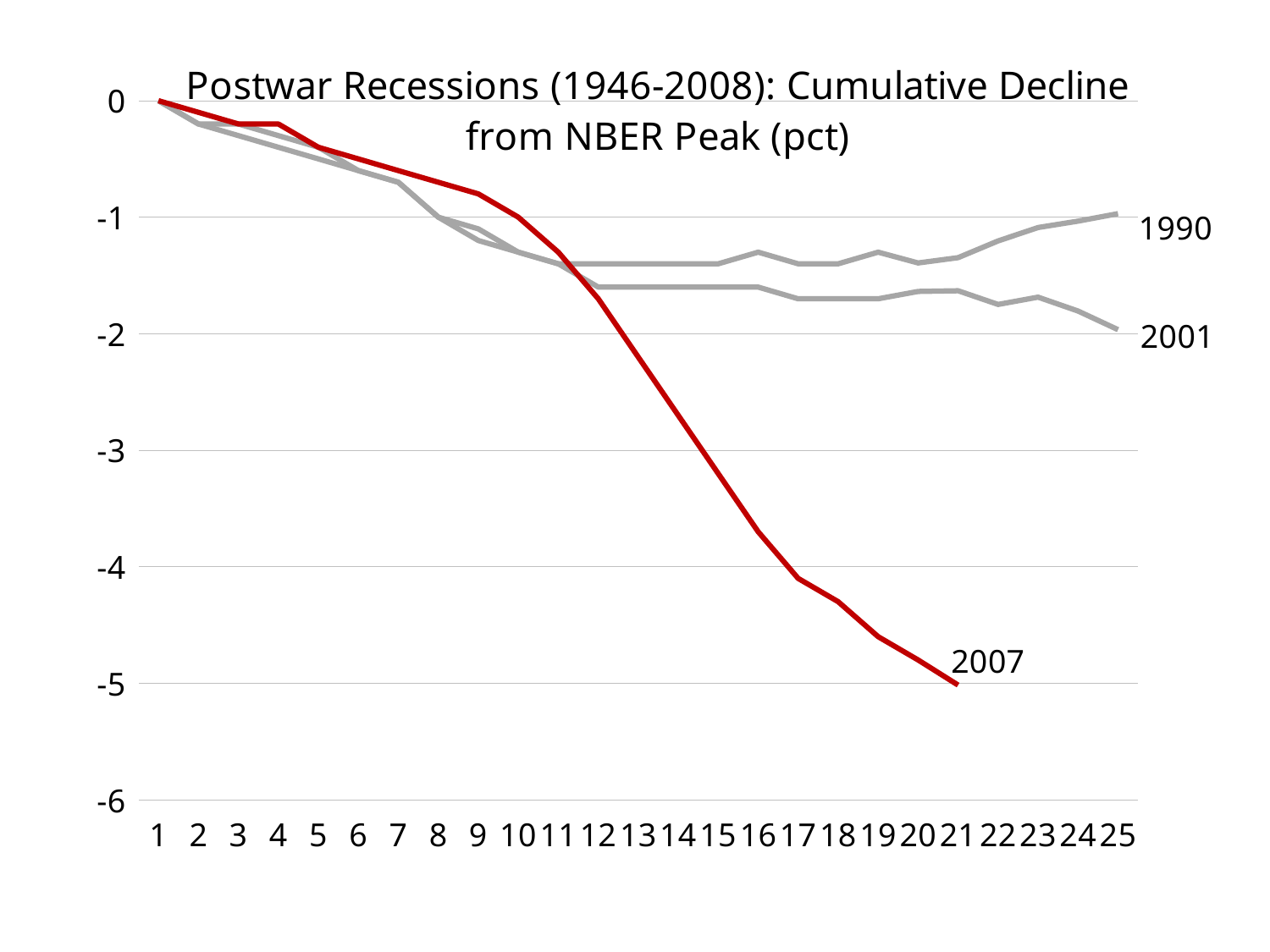
What kind of chart is shown on the slide? line chart How many series (recessions) are plotted on the chart? 3 Is the value of the 2007 series at point 19 greater or less than -4? less What colour is the line for the 2007 series? red Which series has the highest (least negative) value at point 25? 1990 Which series reaches the lowest cumulative decline on the chart? 2007 Does the 2007 series rise or fall as the x axis increases? fall Is the value of the 1990 series at point 25 greater or less than -2? greater How many points are labelled along the x axis? 25 At point 25, which series is higher, 1990 or 2001? 1990 At which x-axis point does the 2007 series end? 21 Is the value of the 2001 series at point 25 greater or less than -1? less